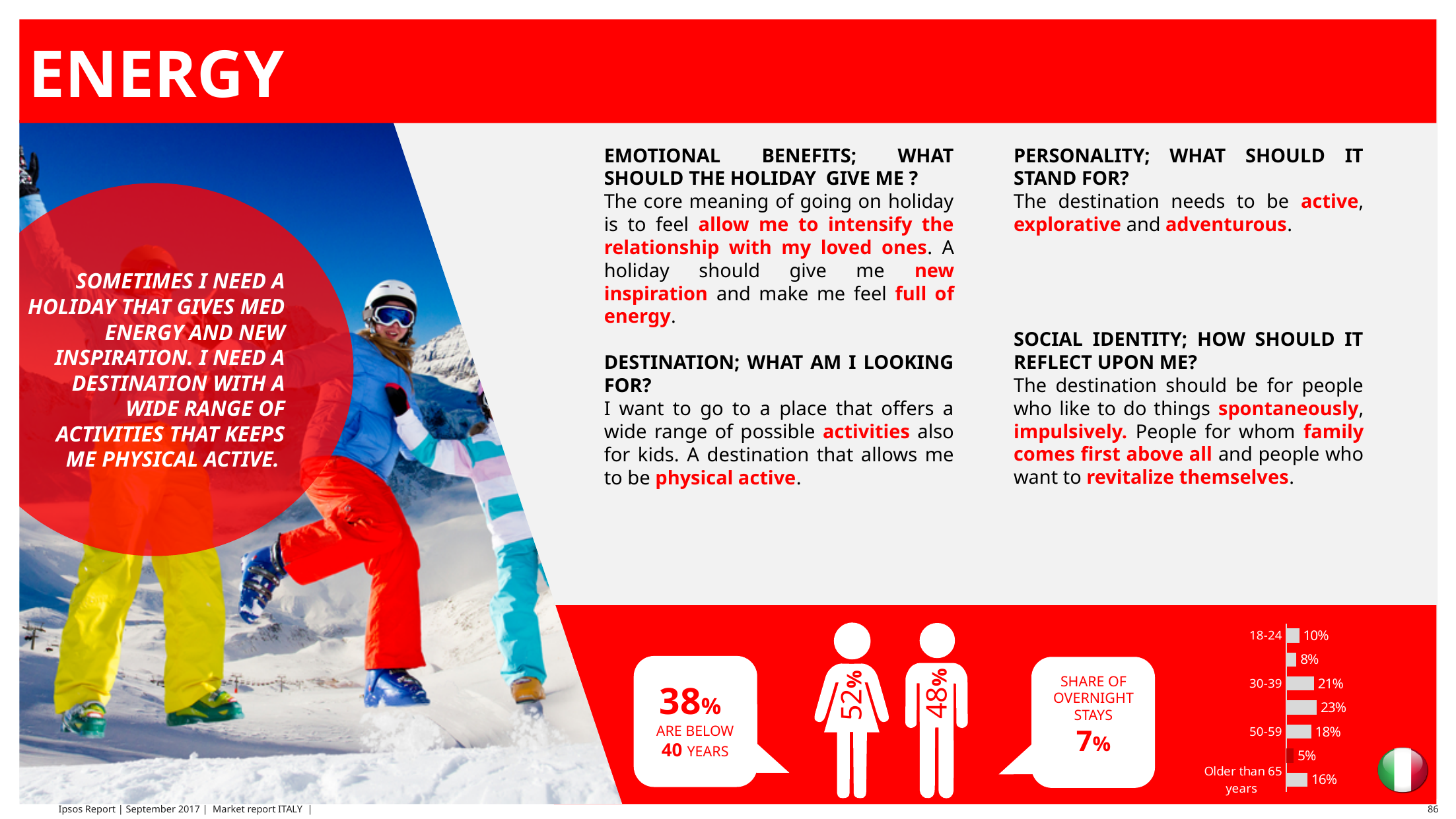
What kind of chart is shown at the bottom right of the slide? bar chart In the bar chart at the bottom right, what is the value for the 18-24 age group? 10% In the bar chart at the bottom right, what is the value for the 30-39 age group? 21% How many bars are plotted in the bar chart at the bottom right of the slide? 7 In the bar chart at the bottom right, which labelled age group has the highest value: 18-24, 30-39, 50-59 or Older than 65 years? 30-39 In the bar chart at the bottom right, what is the highest value shown on any bar? 23% In the bar chart at the bottom right, what is the lowest value shown on any bar? 5% In the bar chart at the bottom right, what is the difference between the values for the 30-39 and 50-59 age groups? 3% In the bar chart at the bottom right, what is the difference between the values for 50-59 and Older than 65 years? 2% In the bar chart at the bottom right, which is larger: the value for 18-24 or the value for 50-59? 50-59 In the bar chart at the bottom right, what is the value for the 'Older than 65 years' group? 16% In the bar chart at the bottom right, what is the value for the 50-59 age group? 18%